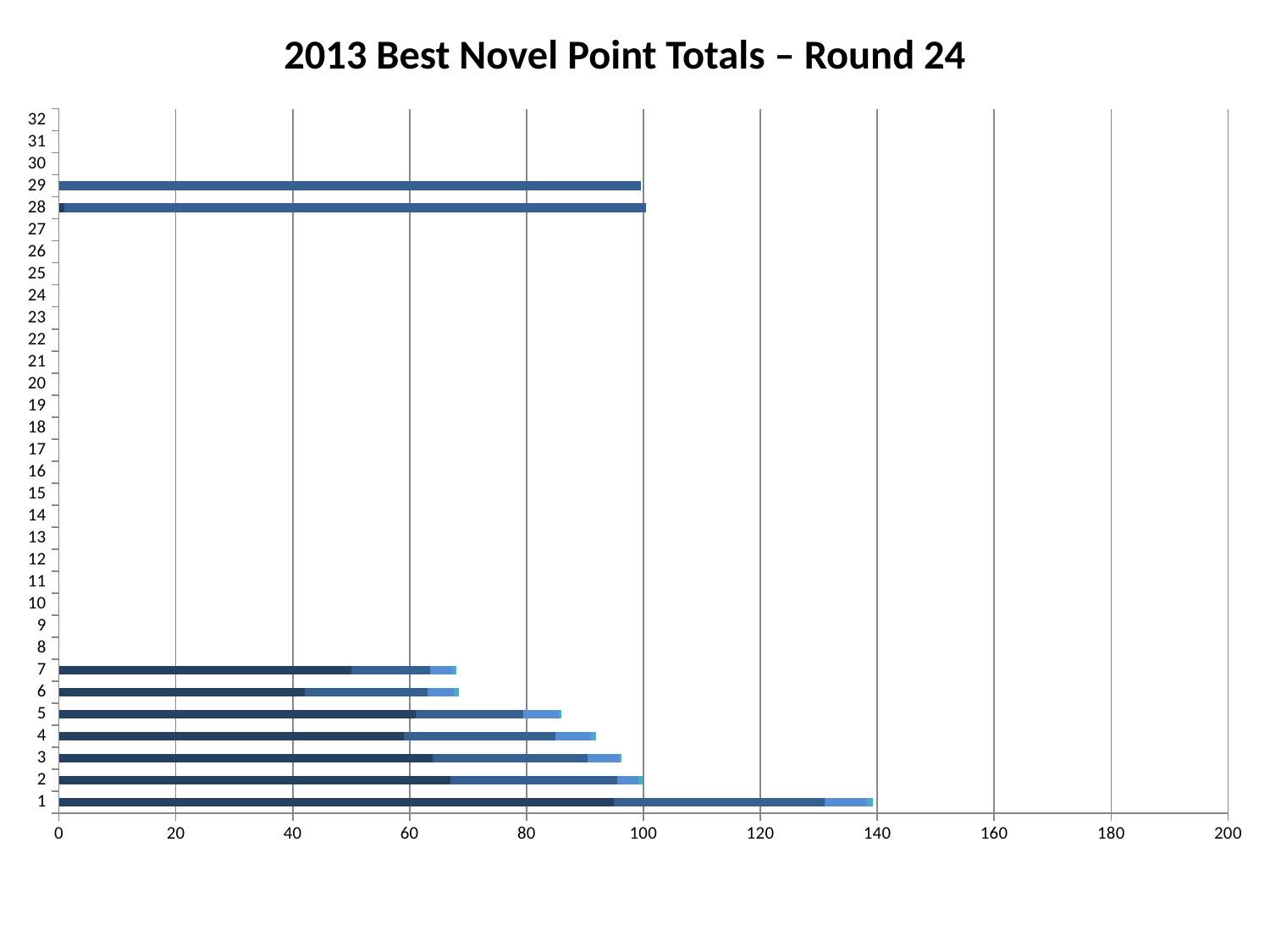
Is the total for category 3 greater or less than 100? less What kind of chart is shown on the slide? bar chart What is the title of the chart? 2013 Best Novel Point Totals – Round 24 Which category has the highest total on the chart? 1 Is the total for category 1 greater or less than 120? greater Which has the larger total, category 3 or category 5? 3 How many categories are listed on the vertical axis of the chart? 32 Is the total for category 7 greater or less than 80? less What is the highest value shown on the horizontal axis? 200 Which has the larger total, category 1 or category 2? 1 How many categories on the chart have a visible bar? 9